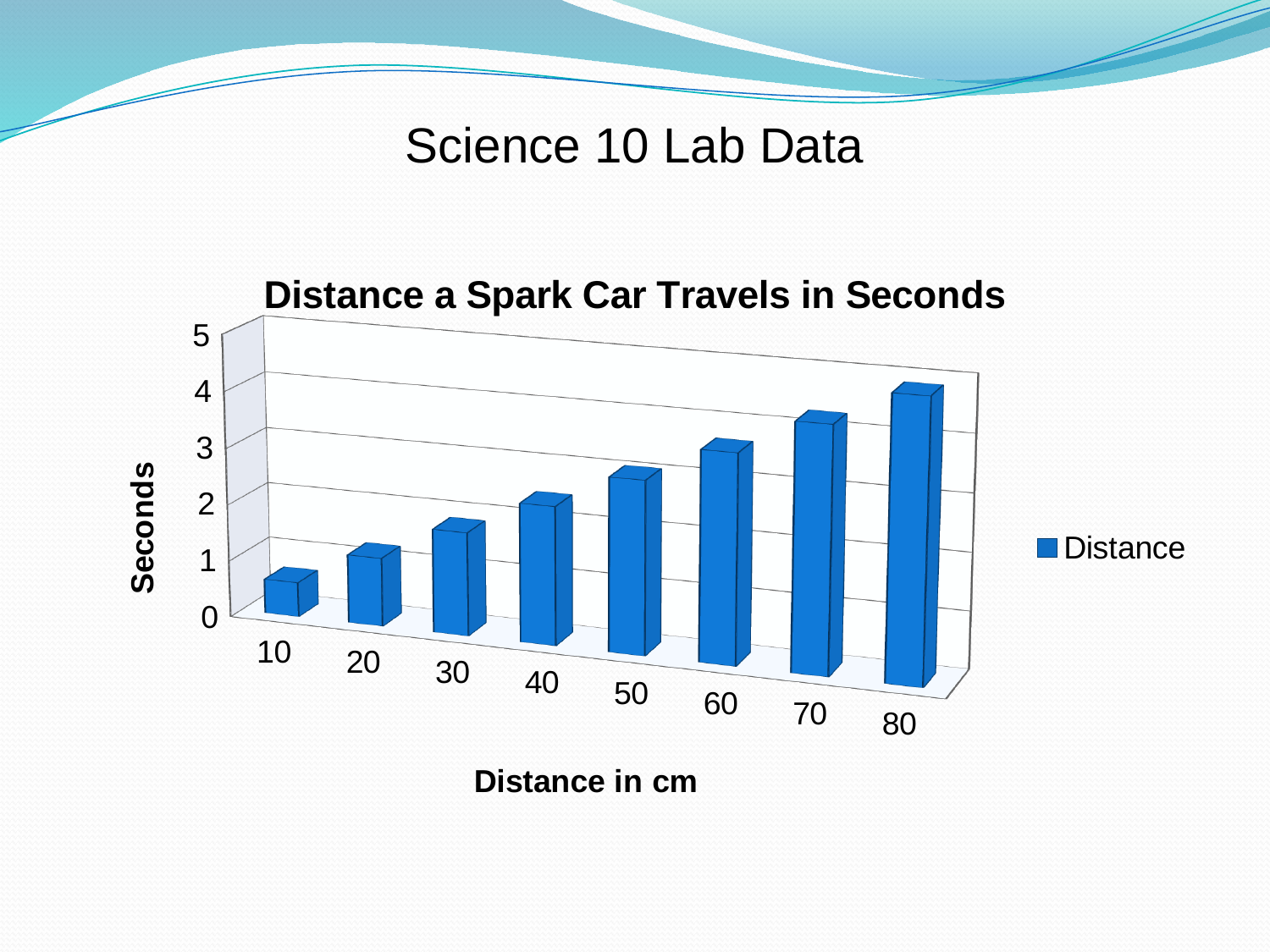
What kind of chart is shown on the slide? bar chart Do the values rise or fall as distance increases along the x axis? rise Which distance has the highest value in seconds? 80 How many series does the legend list? 1 Which has the larger value, 50 cm or 30 cm? 50 Which distance has the lowest value in seconds? 10 What is the label of the y axis? Seconds What is the title of the chart? Distance a Spark Car Travels in Seconds Is the value for 80 cm greater or less than 3 seconds? greater Is the value for 60 cm greater or less than 2 seconds? greater How many distance categories are plotted on the x axis? 8 Is the value for 10 cm greater or less than 1 second? less